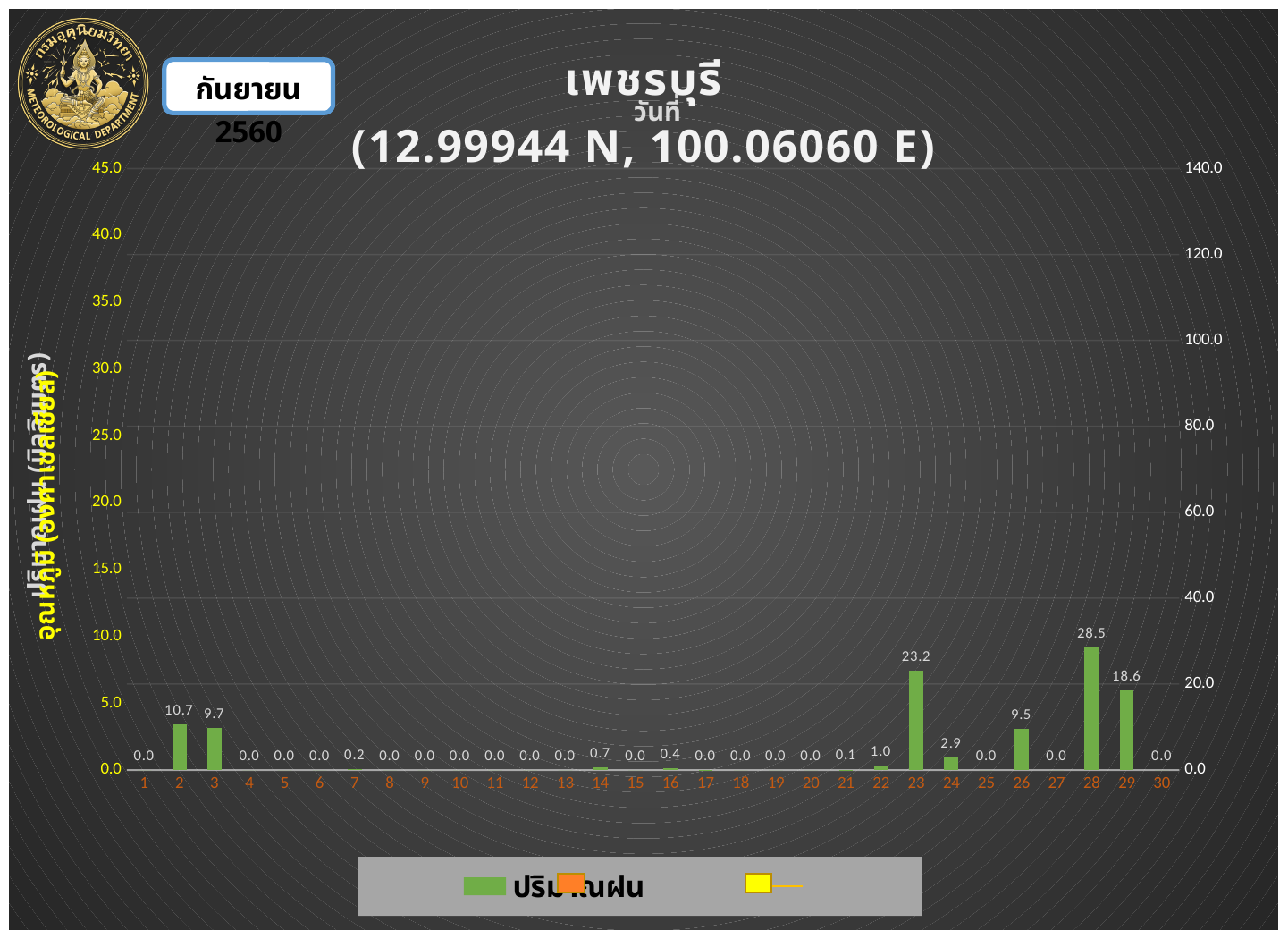
What is the rainfall value shown for day 29? 18.6 What is the rainfall value shown for day 23? 23.2 What is the rainfall value shown for day 28? 28.5 Which is larger, the rainfall value for day 24 or for day 22? day 24 What coordinates are given in the chart title? 12.99944 N, 100.06060 E How many days are shown on the x axis? 30 What is the difference between the rainfall values for day 28 and day 23? 5.3 What is the difference between the rainfall values for day 2 and day 3? 1.0 What is the rainfall value shown for day 2? 10.7 What kind of chart is shown on the slide? bar chart Which is larger, the rainfall value for day 26 or for day 29? day 29 Which day has the highest rainfall value? 28